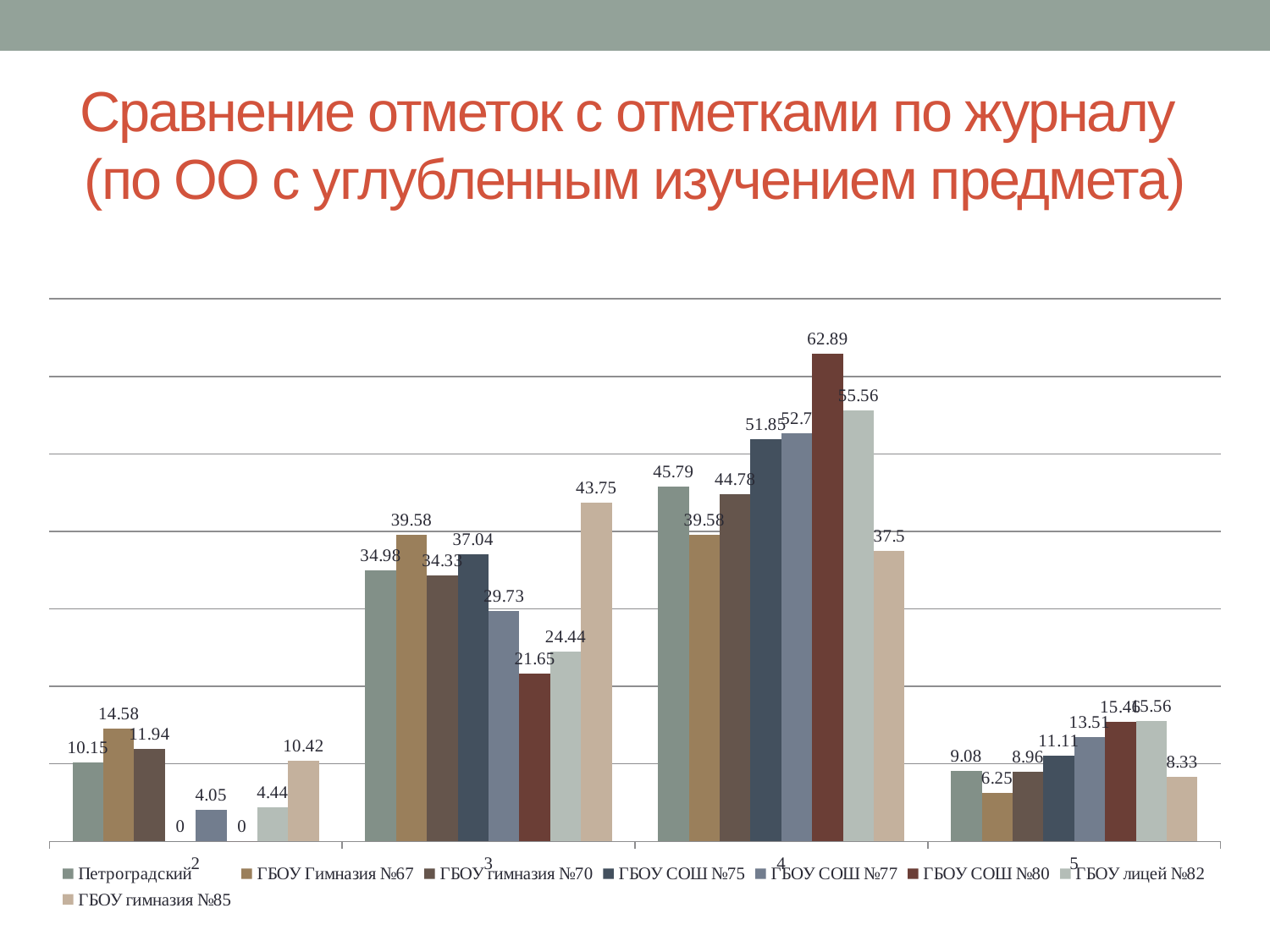
What is the difference between ГБОУ СОШ №80 and ГБОУ лицей №82 in category 4? 7.33 Which series have a value of 0 in category 2? ГБОУ СОШ №75 and ГБОУ СОШ №80 What is the value for ГБОУ СОШ №80 in category 4? 62.89 How many categories are shown on the x axis? 4 Which is larger in category 5: ГБОУ СОШ №77 or ГБОУ гимназия №85? ГБОУ СОШ №77 Which series has the highest value in category 4? ГБОУ СОШ №80 What is the value for ГБОУ Гимназия №67 in category 5? 6.25 Which series has the lowest value in category 3? ГБОУ СОШ №80 What type of chart is shown on the slide? bar chart What is the value for Петроградский in category 2? 10.15 How many series does the legend list? 8 What is the value for ГБОУ гимназия №85 in category 3? 43.75